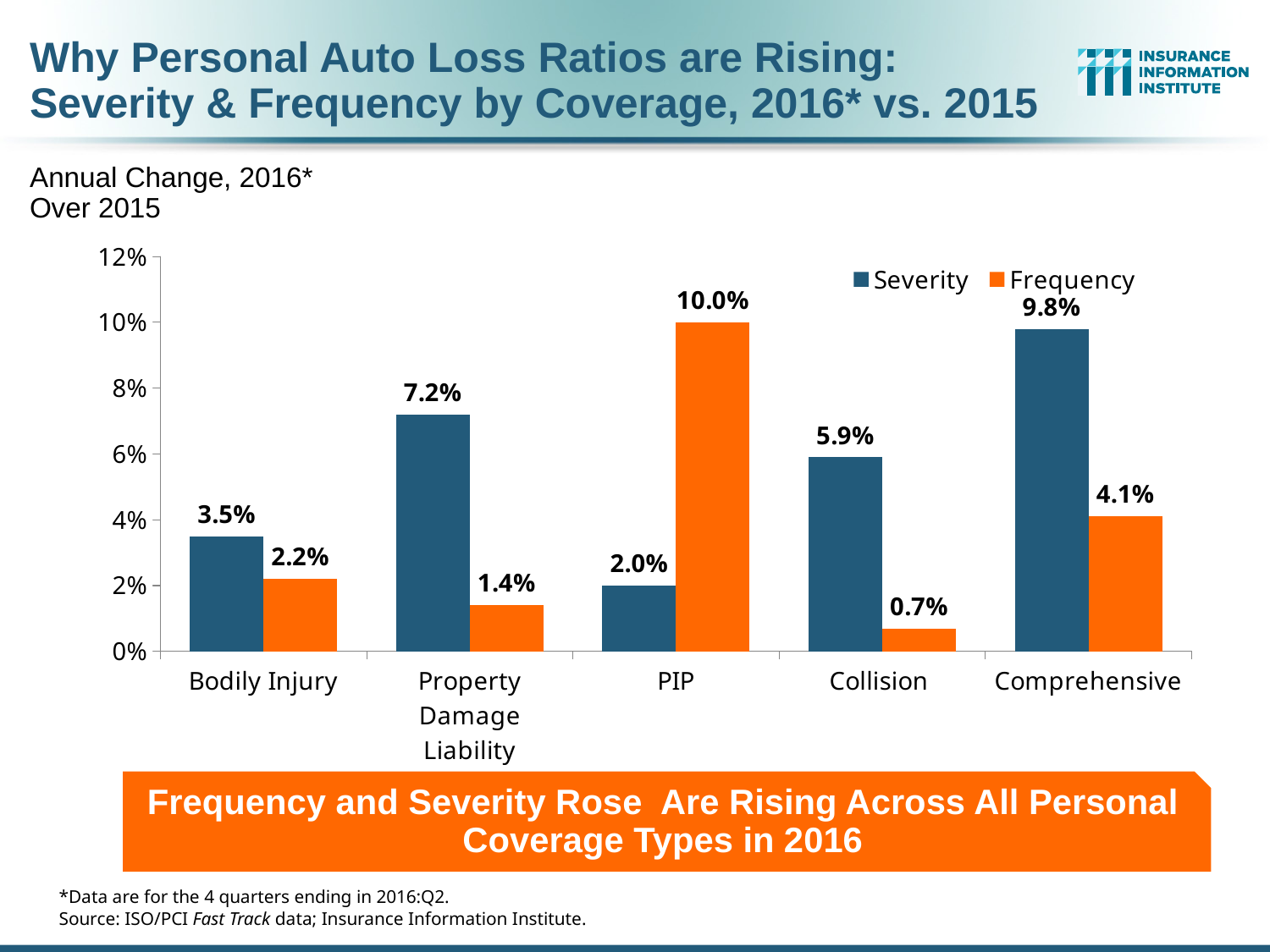
What is the Frequency value for Collision? 0.7% Which coverage type has the highest Severity value? Comprehensive What is the difference between the Frequency and Severity values for PIP? 8.0% What kind of chart is shown on the slide? Bar chart Which is larger for Bodily Injury, Severity or Frequency? Severity What is the Severity value for Property Damage Liability? 7.2% Which coverage type has the lowest Frequency value? Collision How many coverage types are shown on the x axis? 5 What is the Severity value for Comprehensive? 9.8% What is the Frequency value for PIP? 10.0% How many series does the legend list? 2 Is the Severity value for Collision greater or less than 4%? greater